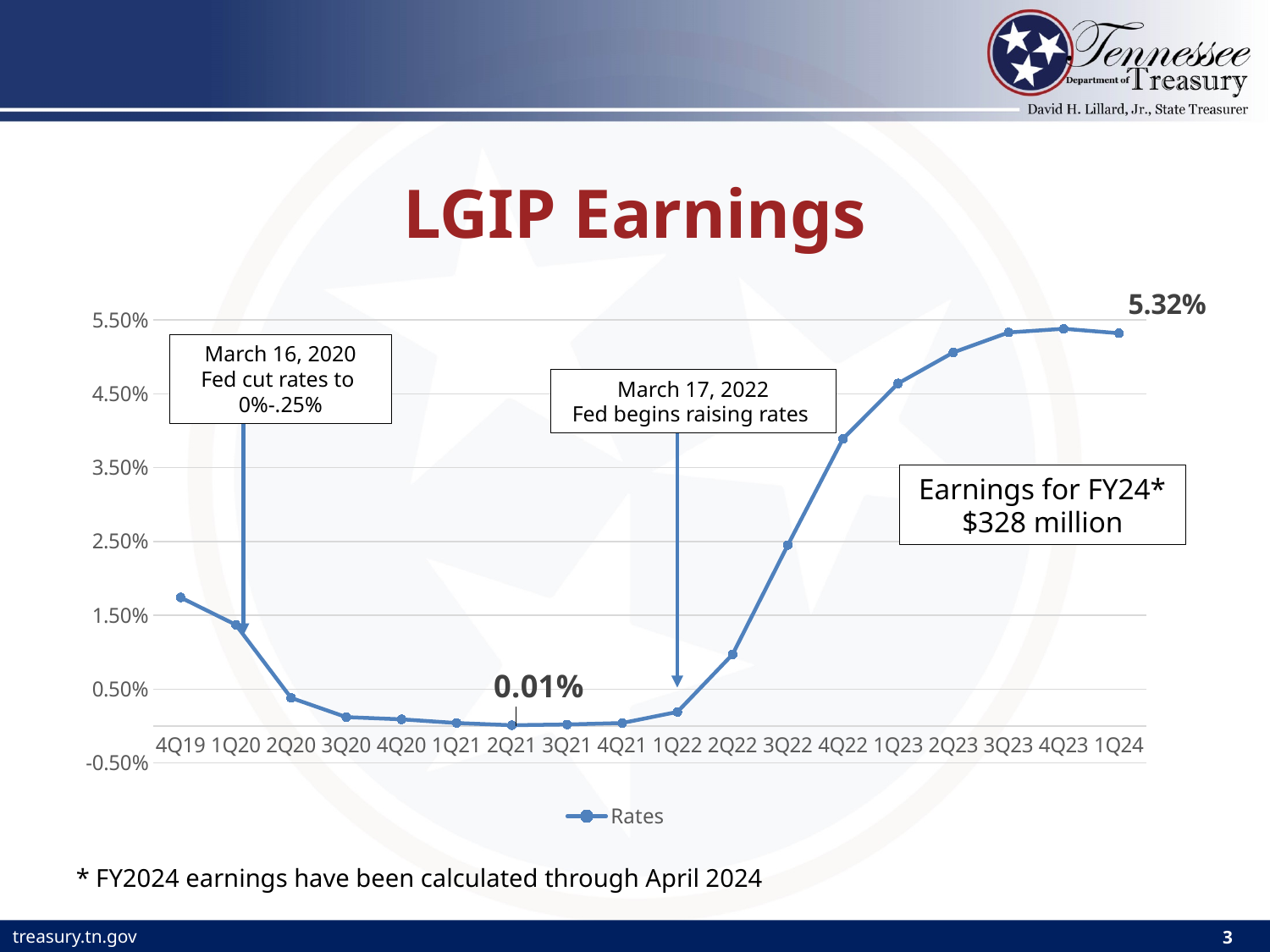
What is the name of the series shown in the legend? Rates How many quarters are shown on the x axis? 18 How many series does the legend list? 1 Is the value for 4Q22 greater or less than 3.50%? greater Do the values rise or fall from 1Q22 to 4Q23? rise Which is larger, the value for 4Q22 or the value for 2Q22? 4Q22 What type of chart is shown on the slide? line chart Is the value for 2Q23 greater or less than 4.50%? greater What is the value labelled for 1Q24? 5.32% What is the difference between the labelled 1Q24 value and the labelled 2Q21 value? 5.31% Is the value for 4Q19 greater or less than 1.50%? greater What is the value labelled at the low point of the line, at 2Q21? 0.01%